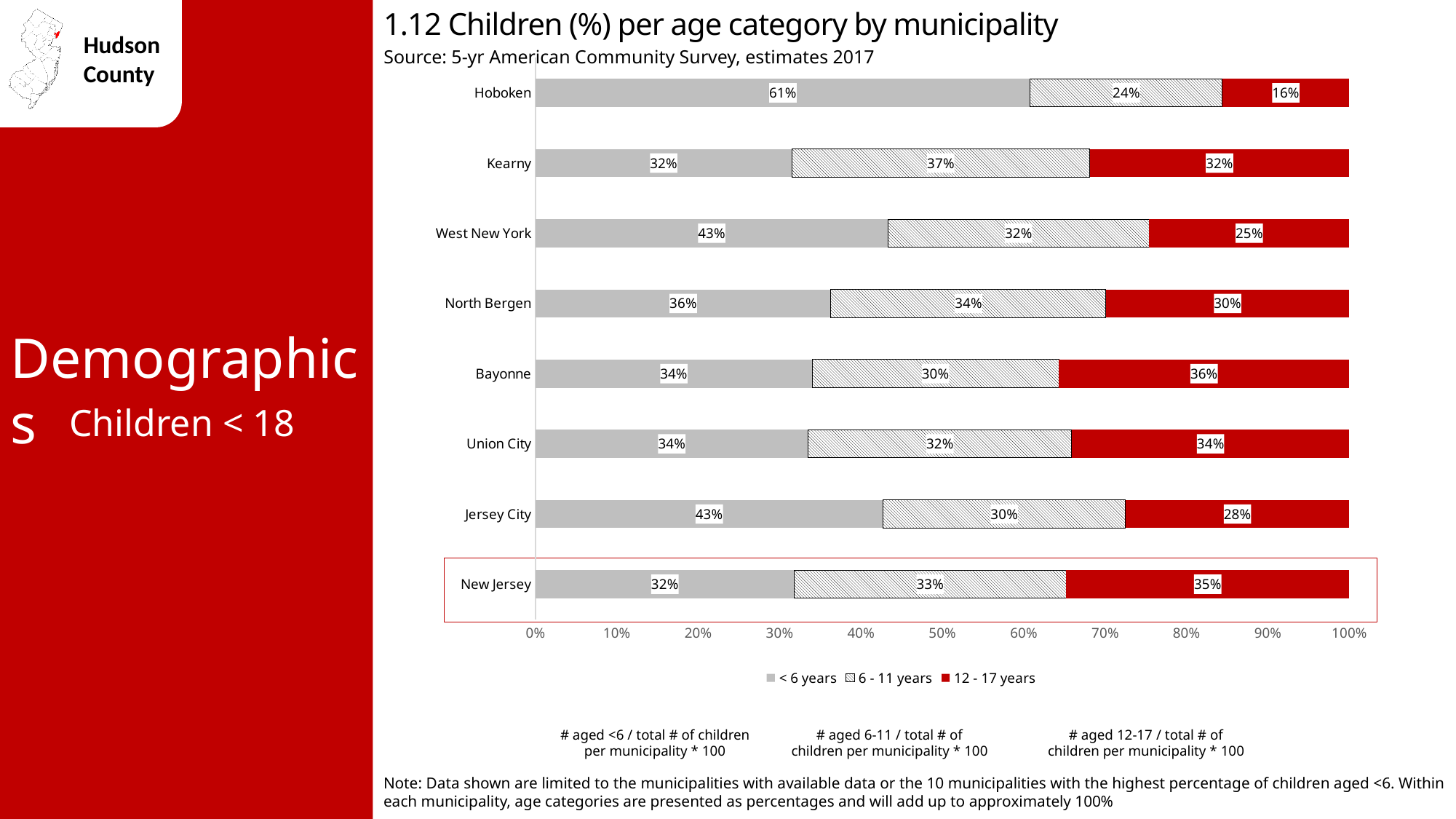
What percentage of children in Hoboken are under 6 years old? 61% How many series does the legend list? 3 What is the value for the 12 - 17 years series for Bayonne? 36% What is the difference between the < 6 years value for Jersey City and the < 6 years value for New Jersey? 11% Which is larger: the 6 - 11 years value for West New York or the 6 - 11 years value for Hoboken? West New York Which municipality has the highest value for the < 6 years series? Hoboken How many municipalities or categories are shown on the chart? 8 What kind of chart is shown on the slide? Stacked bar chart What is the 6 - 11 years value for Kearny? 37% What is the total of the stacked bar for North Bergen? 100% Which series is shown in red in the legend? 12 - 17 years Which category has the lowest value for the 12 - 17 years series? Hoboken